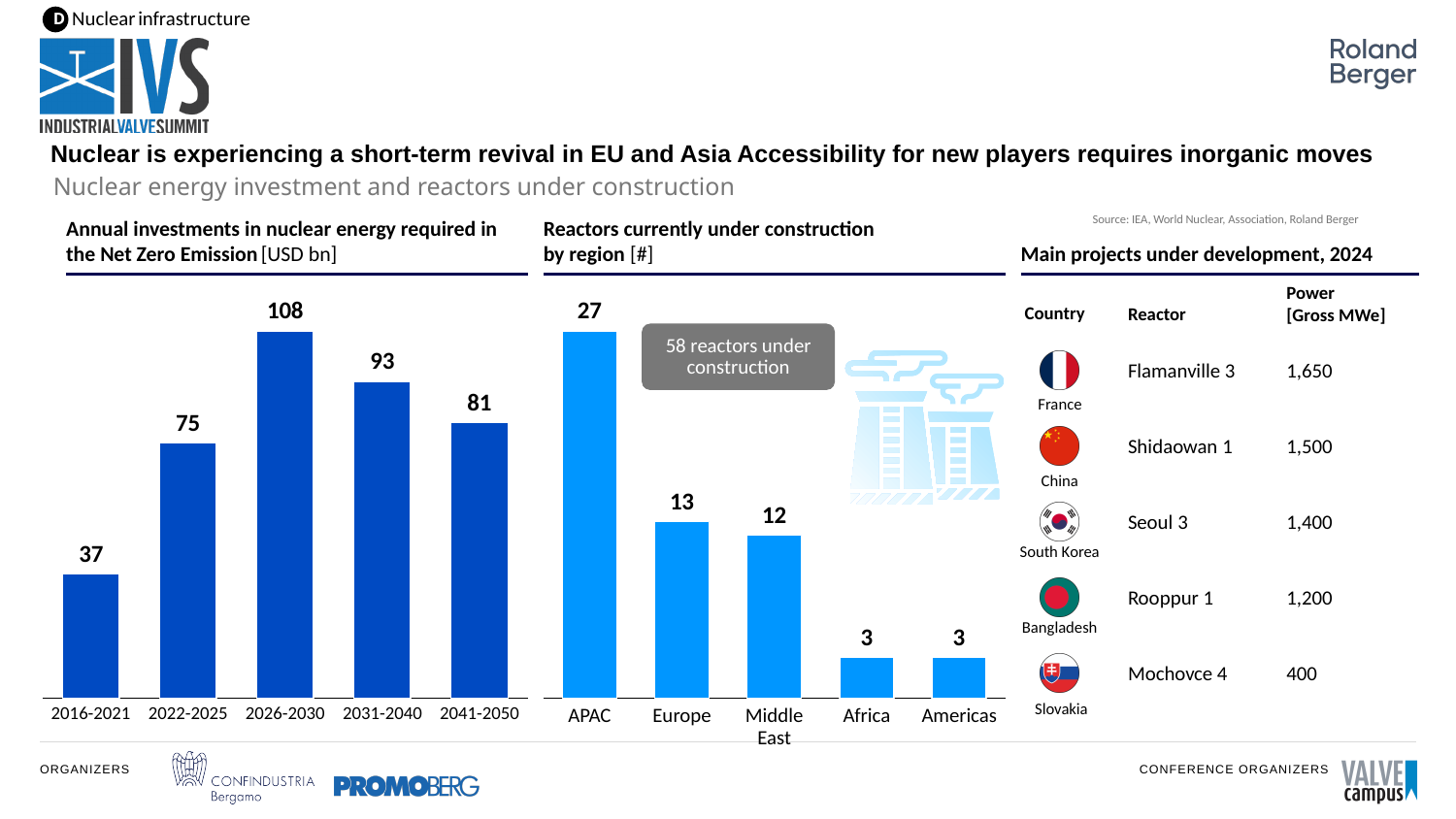
What unit is given in the title of the 'Annual investments in nuclear energy required in the Net Zero Emission' chart? USD bn What type of chart is the 'Reactors currently under construction by region' chart? bar chart In the 'Annual investments in nuclear energy required in the Net Zero Emission' chart, what is the value for 2026-2030? 108 In the 'Reactors currently under construction by region' chart, which region has the highest number of reactors? APAC In the 'Annual investments in nuclear energy required in the Net Zero Emission' chart, which period has the lowest value? 2016-2021 In the 'Annual investments in nuclear energy required in the Net Zero Emission' chart, how many periods are shown? 5 In the 'Reactors currently under construction by region' chart, what is the value for APAC? 27 In the 'Reactors currently under construction by region' chart, what is the total number of reactors under construction stated in the callout? 58 In the 'Annual investments in nuclear energy required in the Net Zero Emission' chart, what is the difference between the values for 2026-2030 and 2016-2021? 71 In the 'Reactors currently under construction by region' chart, what is the difference between Europe and Middle East? 1 In the 'Reactors currently under construction by region' chart, how many regions are shown? 5 In the 'Annual investments in nuclear energy required in the Net Zero Emission' chart, is the value for 2031-2040 larger or smaller than the value for 2041-2050? larger